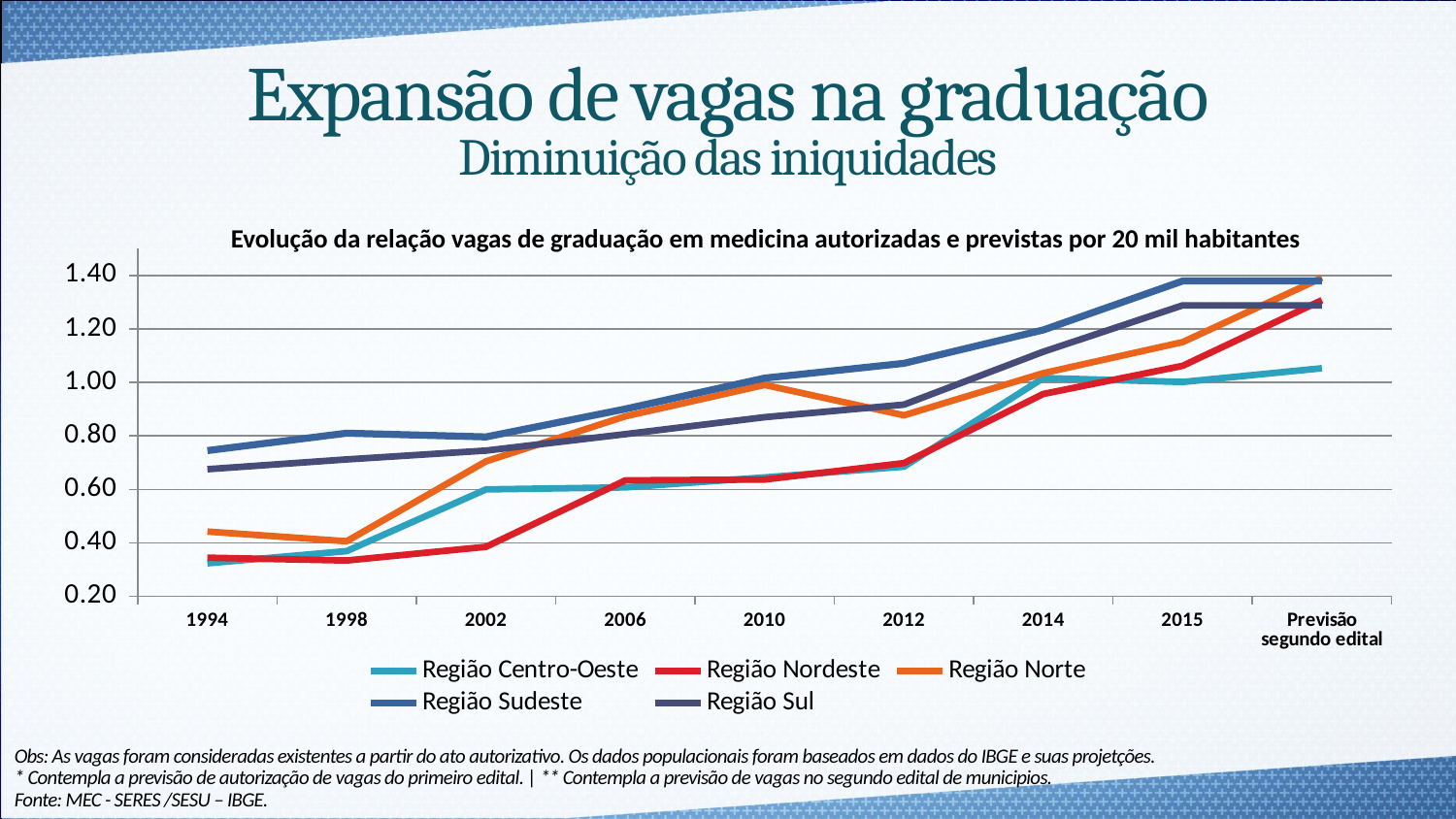
How many series does the legend list? 5 How many points are shown along the x axis? 9 Does the value for Região Sudeste rise or fall from 1994 to 2015? rise Which region has the highest value in 1994? Região Sudeste Is the value for Região Centro-Oeste in 2015 greater or less than 1.20? less In 2002, which is larger: the value for Região Norte or Região Nordeste? Região Norte What kind of chart is shown on the slide? line chart Is the value for Região Centro-Oeste in 1994 greater or less than 0.40? less Is the value for Região Sul in 2015 greater or less than 1.20? greater Which region has the highest value in 2015? Região Sudeste What is the title of the chart? Evolução da relação vagas de graduação em medicina autorizadas e previstas por 20 mil habitantes